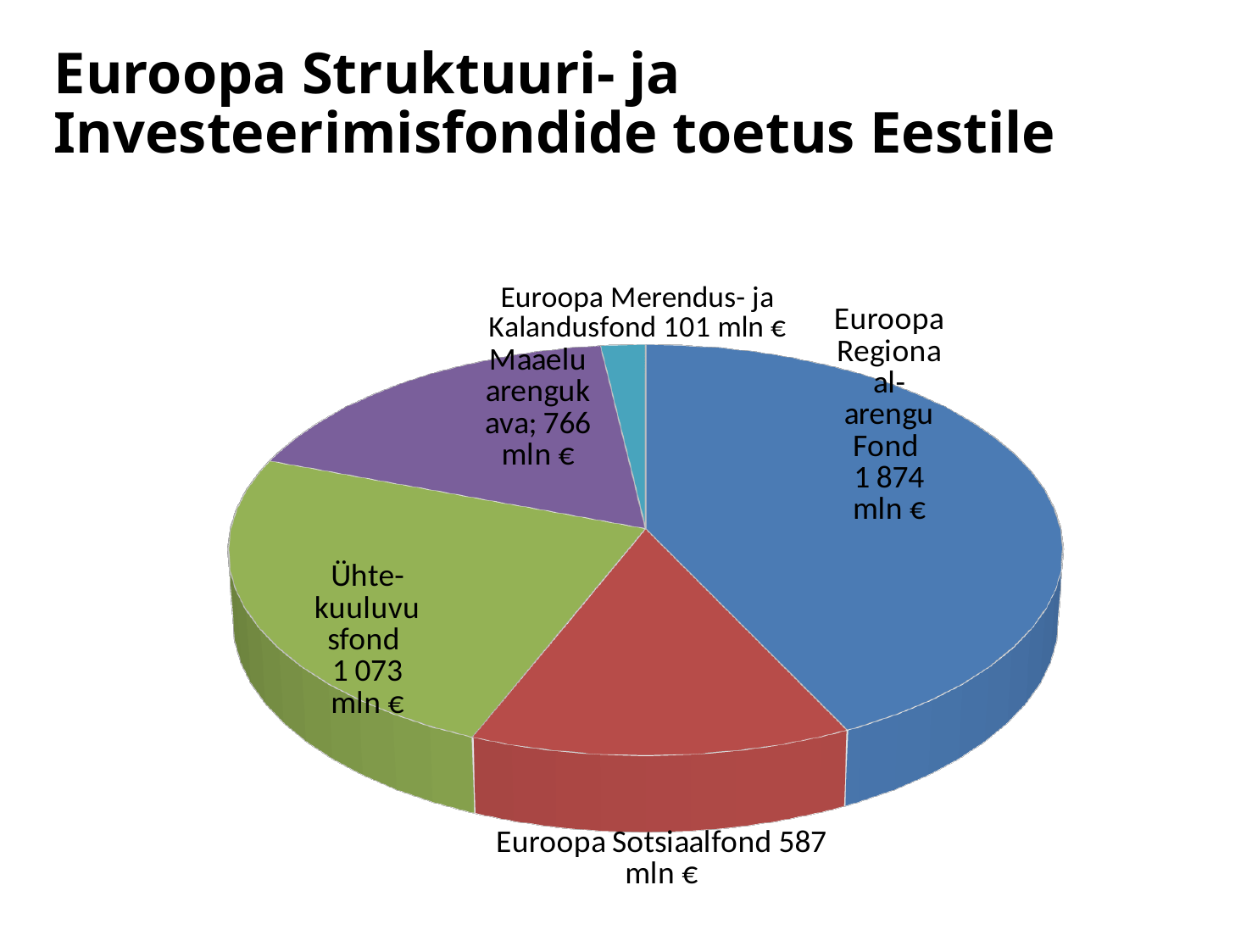
What is the value for Euroopa Sotsiaalfond? 587 mln € What kind of chart is shown on the slide? Pie chart What is the value for Euroopa Merendus- ja Kalandusfond? 101 mln € What is the value for Ühtekuuluvusfond? 1 073 mln € What is the value for Maaelu arengukava? 766 mln € Which fund has the largest share of the pie? Euroopa Regionaalarengu Fond How much larger is the value for Euroopa Regionaalarengu Fond than for Ühtekuuluvusfond? 801 mln € Which fund has the smallest share of the pie? Euroopa Merendus- ja Kalandusfond What is the title of the slide? Euroopa Struktuuri- ja Investeerimisfondide toetus Eestile How many slices does the pie chart have? 5 What is the value for Euroopa Regionaalarengu Fond? 1 874 mln € Which is larger, the value for Maaelu arengukava or for Euroopa Sotsiaalfond? Maaelu arengukava